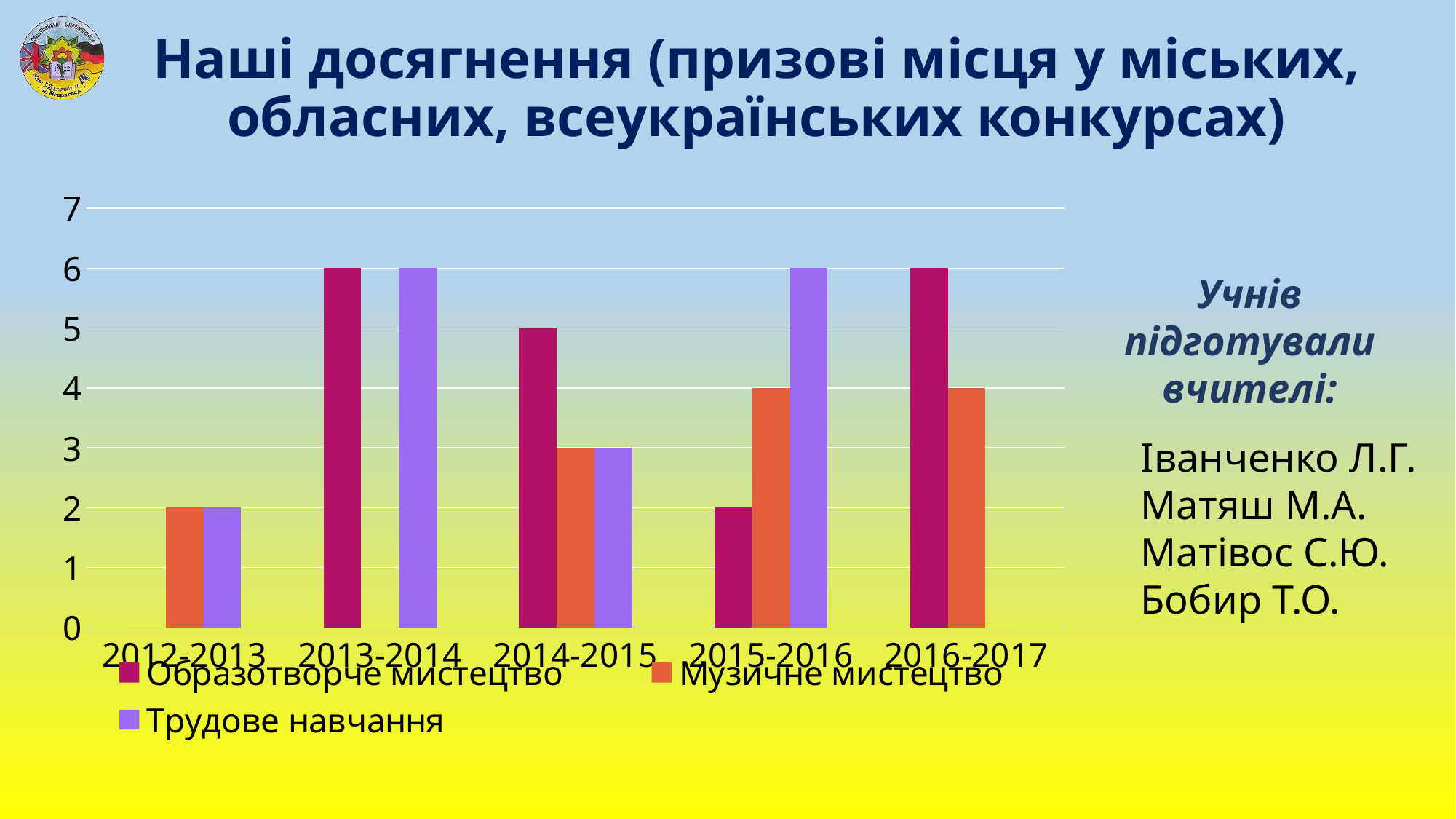
What is the value for Трудове навчання in 2013-2014? 6 What is the value for Музичне мистецтво in 2015-2016? 4 What is the difference between Образотворче мистецтво and Музичне мистецтво in 2016-2017? 2 How many school-year categories are shown on the x axis? 5 How many series does the legend list? 3 Which is larger in 2015-2016: Образотворче мистецтво or Трудове навчання? Трудове навчання What kind of chart is shown on the slide? bar chart Is the value for Образотворче мистецтво in 2013-2014 greater or less than 4? greater Does the value for Музичне мистецтво rise or fall from 2014-2015 to 2015-2016? rise In which year is the value for Трудове навчання lowest among the years where it has a visible bar? 2012-2013 What is the value for Образотворче мистецтво in 2014-2015? 5 Which legend entry is shown in orange? Музичне мистецтво